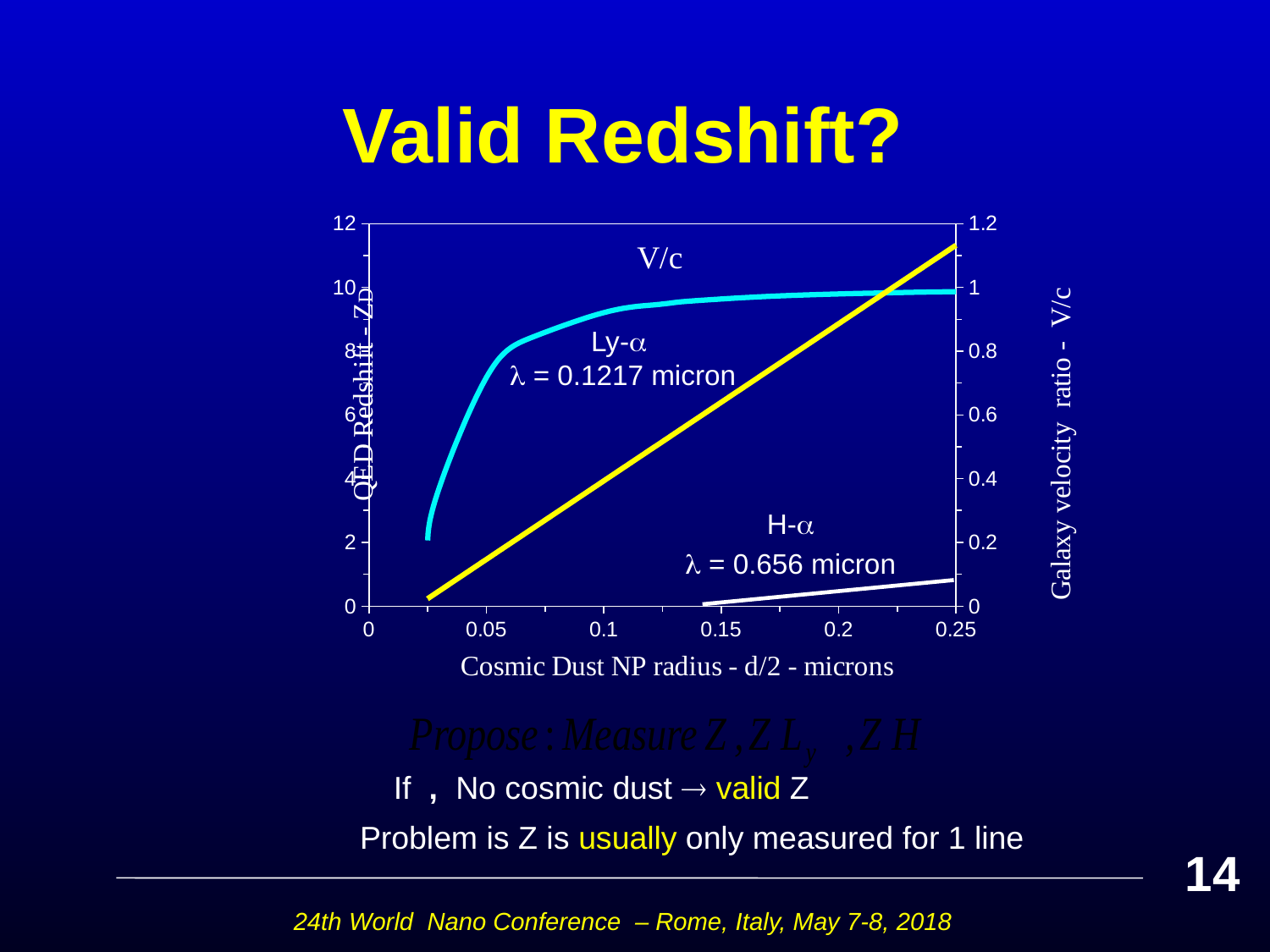
Is the QED Redshift Z of the H-α line at a radius of 0.25 microns greater or less than 2? less What wavelength λ is given for the Ly-α line on the chart? 0.1217 micron What is the label of the x axis of the chart? Cosmic Dust NP radius - d/2 - microns Which line has the lowest QED Redshift Z values on the chart? H-α Is the V/c value of the yellow line at a radius of 0.25 microns greater or less than 1? greater Is the QED Redshift Z of the Ly-α line at a radius of 0.1 microns greater or less than 8? less How many lines are plotted on the chart? 3 Which line reaches the highest QED Redshift Z value on the chart? Ly-α Does the V/c line rise or fall as the cosmic dust NP radius increases? rises What kind of chart is shown on the slide? line chart Does the Ly-α line rise or fall as the cosmic dust NP radius increases from 0.025 to 0.1 microns? rises At a radius of 0.25 microns, which line has the larger QED Redshift Z, Ly-α or H-α? Ly-α